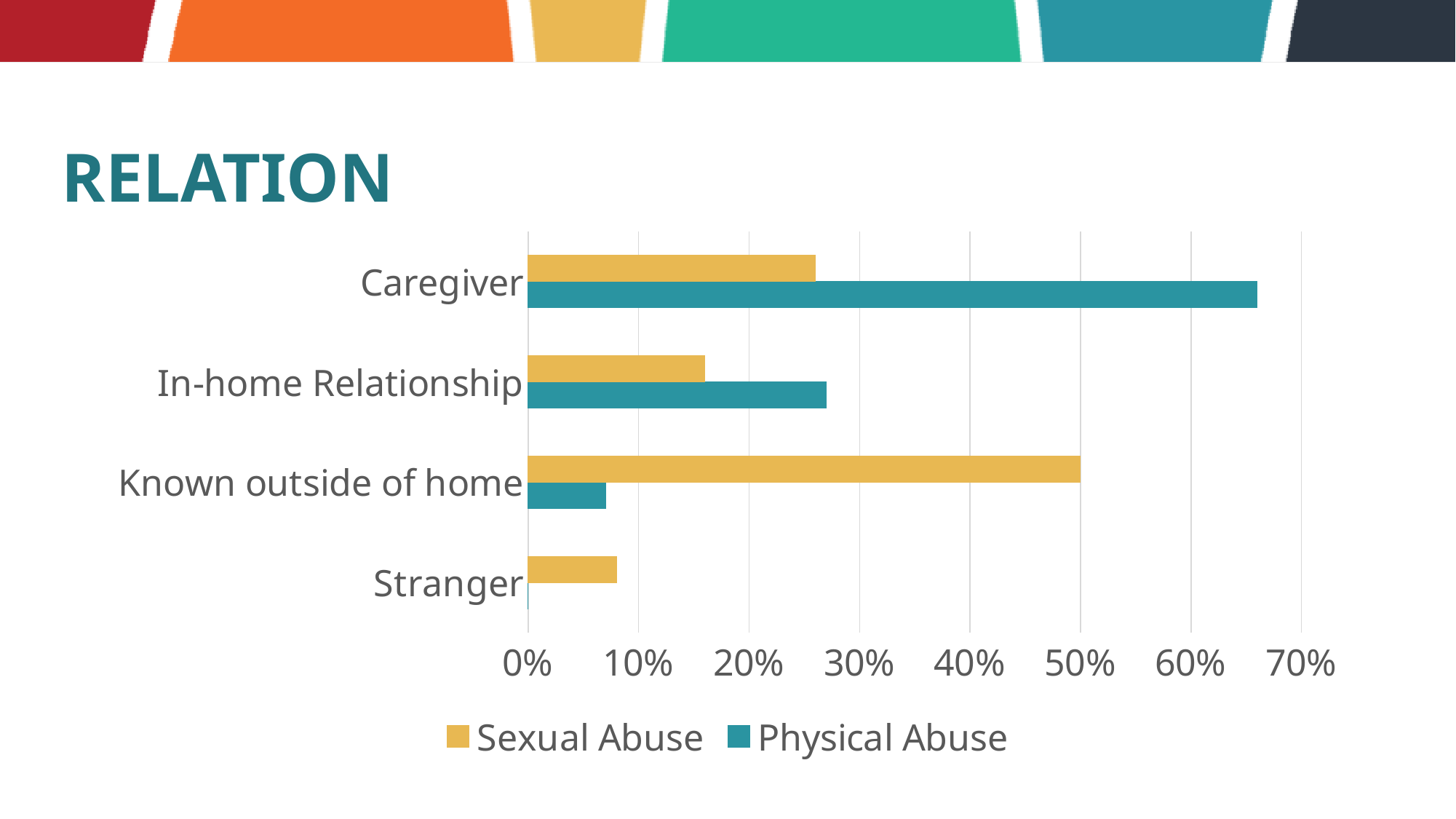
For Known outside of home, which is larger: Sexual Abuse or Physical Abuse? Sexual Abuse Is the Physical Abuse value for Caregiver greater or less than 60%? greater How many relation categories are plotted on the chart? 4 Which category has the highest Sexual Abuse value? Known outside of home Is the Sexual Abuse value for Stranger greater or less than 10%? less Which category has the highest Physical Abuse value? Caregiver Is the Physical Abuse value for In-home Relationship greater or less than 20%? greater For Caregiver, which is larger: Sexual Abuse or Physical Abuse? Physical Abuse What is the title of the slide containing the chart? RELATION What kind of chart is shown on the slide? bar chart Which category has the lowest Sexual Abuse value? Stranger How many series does the legend list? 2